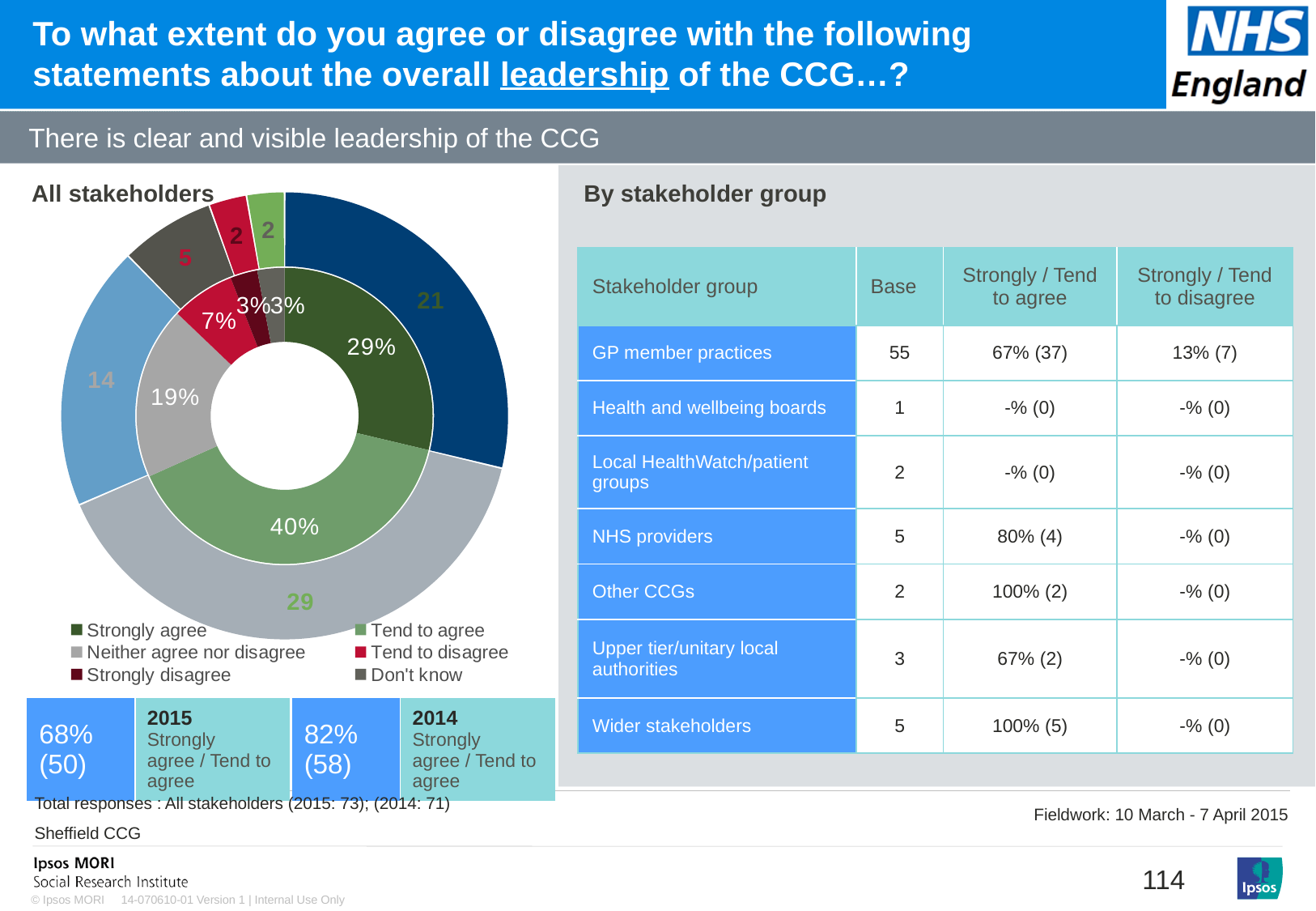
Which is larger in the All stakeholders chart: 'Neither agree nor disagree' or 'Tend to disagree'? Neither agree nor disagree What percentage of all stakeholders tend to agree? 40% How many respondents are shown in the outer ring for 'Neither agree nor disagree'? 14 Which response category has the largest share in the All stakeholders chart? Tend to agree What is the difference in percentage points between 'Tend to agree' and 'Strongly agree' in the All stakeholders chart? 11 What percentage of all stakeholders strongly agree that there is clear and visible leadership of the CCG? 29% How many respondents are shown in the outer ring for 'Strongly agree'? 21 What percentage of all stakeholders neither agree nor disagree? 19% What type of chart is used for the All stakeholders data? Doughnut chart How many response categories does the legend of the All stakeholders chart list? 6 What percentage of all stakeholders tend to disagree? 7% What colour represents 'Strongly agree' in the All stakeholders chart? Dark green